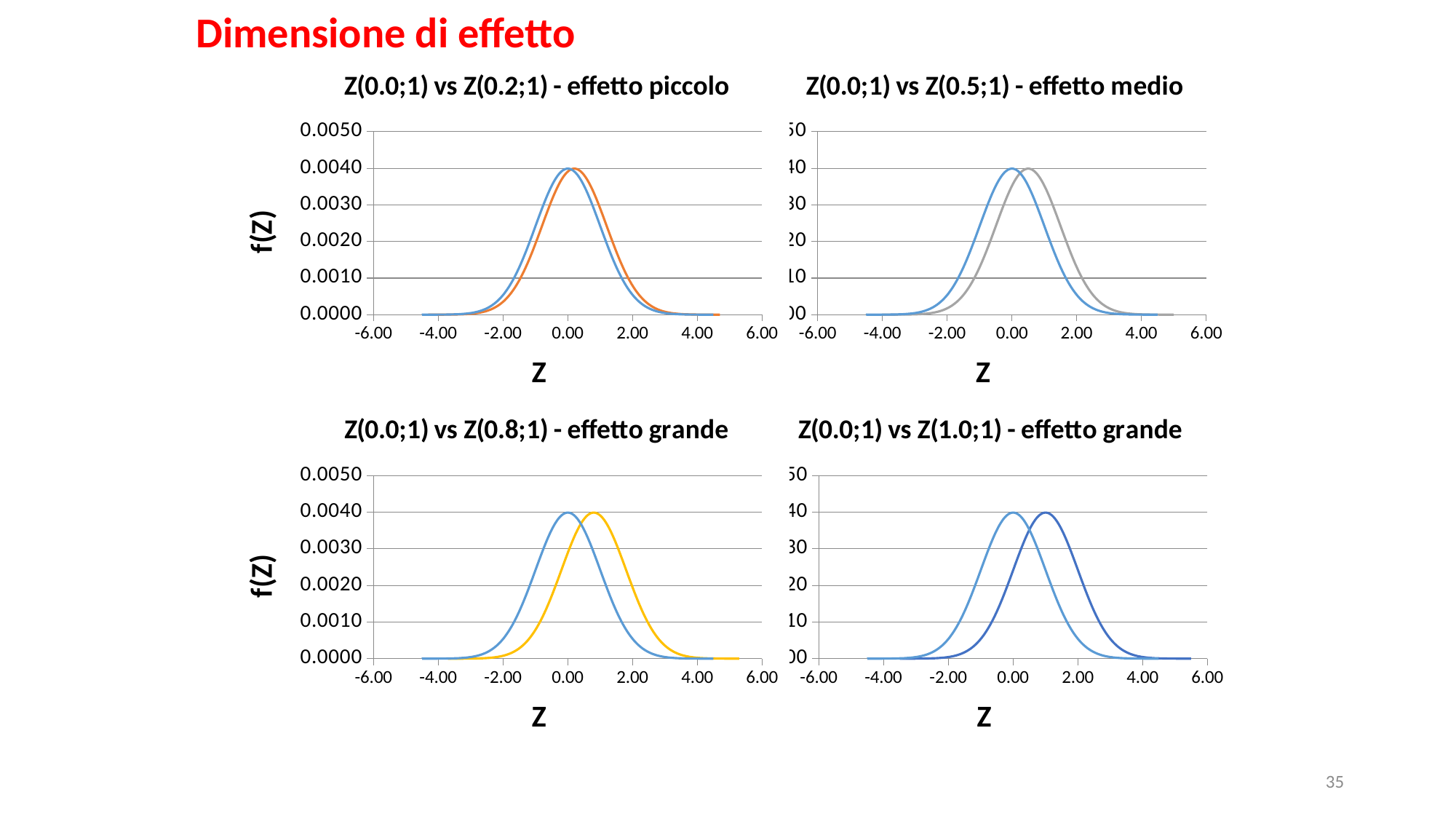
In the bottom-left chart "Z(0.0;1) vs Z(0.8;1) - effetto grande", is the peak value of the yellow curve greater or less than 0.0050? less What is the label of the x axis in the bottom-left chart "Z(0.0;1) vs Z(0.8;1) - effetto grande"? Z What is the title of the top-right chart on the slide? Z(0.0;1) vs Z(0.5;1) - effetto medio In the top-left chart "Z(0.0;1) vs Z(0.2;1) - effetto piccolo", is the peak value of the curves greater or less than 0.0030? greater What kind of chart is the top-left chart titled "Z(0.0;1) vs Z(0.2;1) - effetto piccolo"? Line chart What is the highest tick value shown on the y axis of the top-left chart "Z(0.0;1) vs Z(0.2;1) - effetto piccolo"? 0.0050 Which of the four charts shows the largest horizontal separation between the two curves? Z(0.0;1) vs Z(1.0;1) - effetto grande How many charts are shown on the slide? 4 Which of the four charts shows the smallest horizontal separation between the two curves? Z(0.0;1) vs Z(0.2;1) - effetto piccolo In the top-right chart "Z(0.0;1) vs Z(0.5;1) - effetto medio", which curve peaks further to the right along the Z axis, the blue one or the grey one? The grey one How many curves are plotted in the bottom-right chart titled "Z(0.0;1) vs Z(1.0;1) - effetto grande"? 2